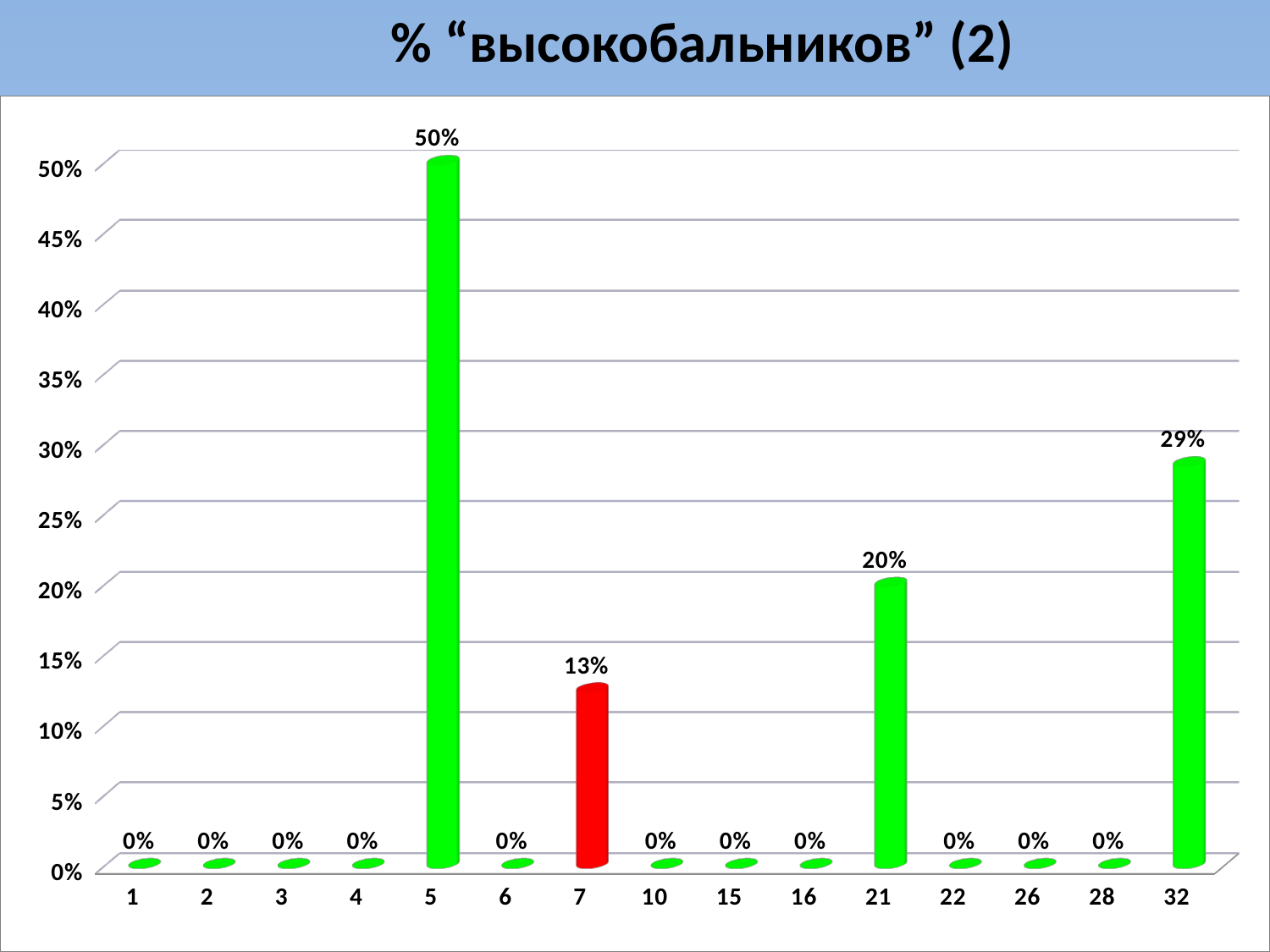
What is the difference between the values for category 5 and category 32? 21% Which is larger, the value for category 21 or the value for category 32? 32 What is the value for category 5? 50% What is the value for category 32? 29% What is the value for category 21? 20% How many categories have a value of 0%? 11 What kind of chart is shown on the slide? bar chart What is the value for category 7? 13% Which category's bar is coloured red? 7 Which category has the highest value? 5 What is the difference between the values for category 21 and category 7? 7% How many categories are shown on the x axis? 15